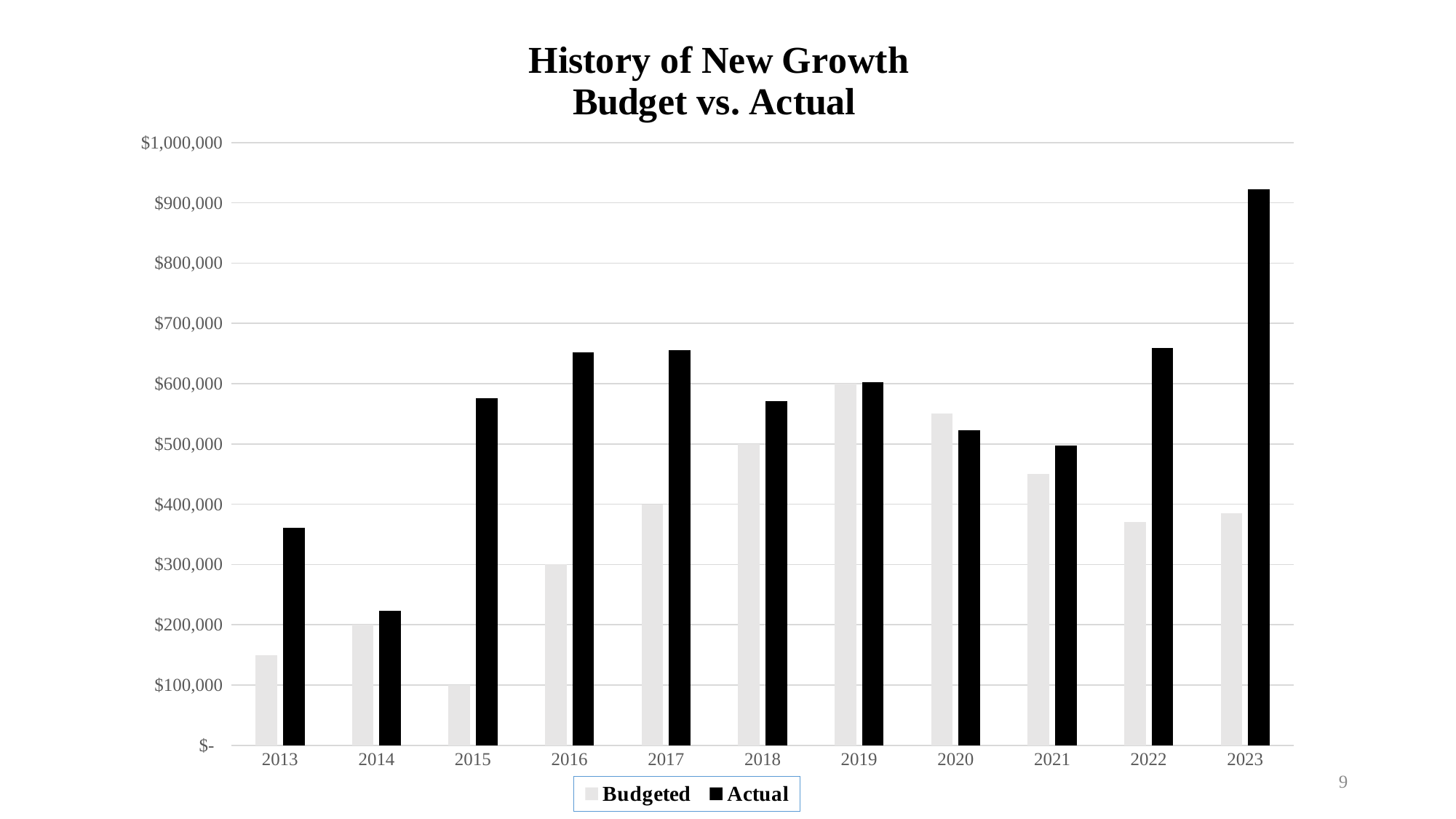
In 2015, which is larger, the Budgeted value or the Actual value? Actual How many years are shown on the x axis? 11 Which year has the highest Actual value? 2023 What is the Budgeted value for 2017? $400,000 Is the Actual value for 2013 greater or less than $300,000? greater What type of chart is shown on the slide? Bar chart What is the Budgeted value for 2015? $100,000 Is the Actual value for 2023 greater or less than $900,000? greater How many series does the legend list? 2 Which year has the lowest Actual value? 2014 What is the Budgeted value for 2019? $600,000 Which year has the lowest Budgeted value? 2015